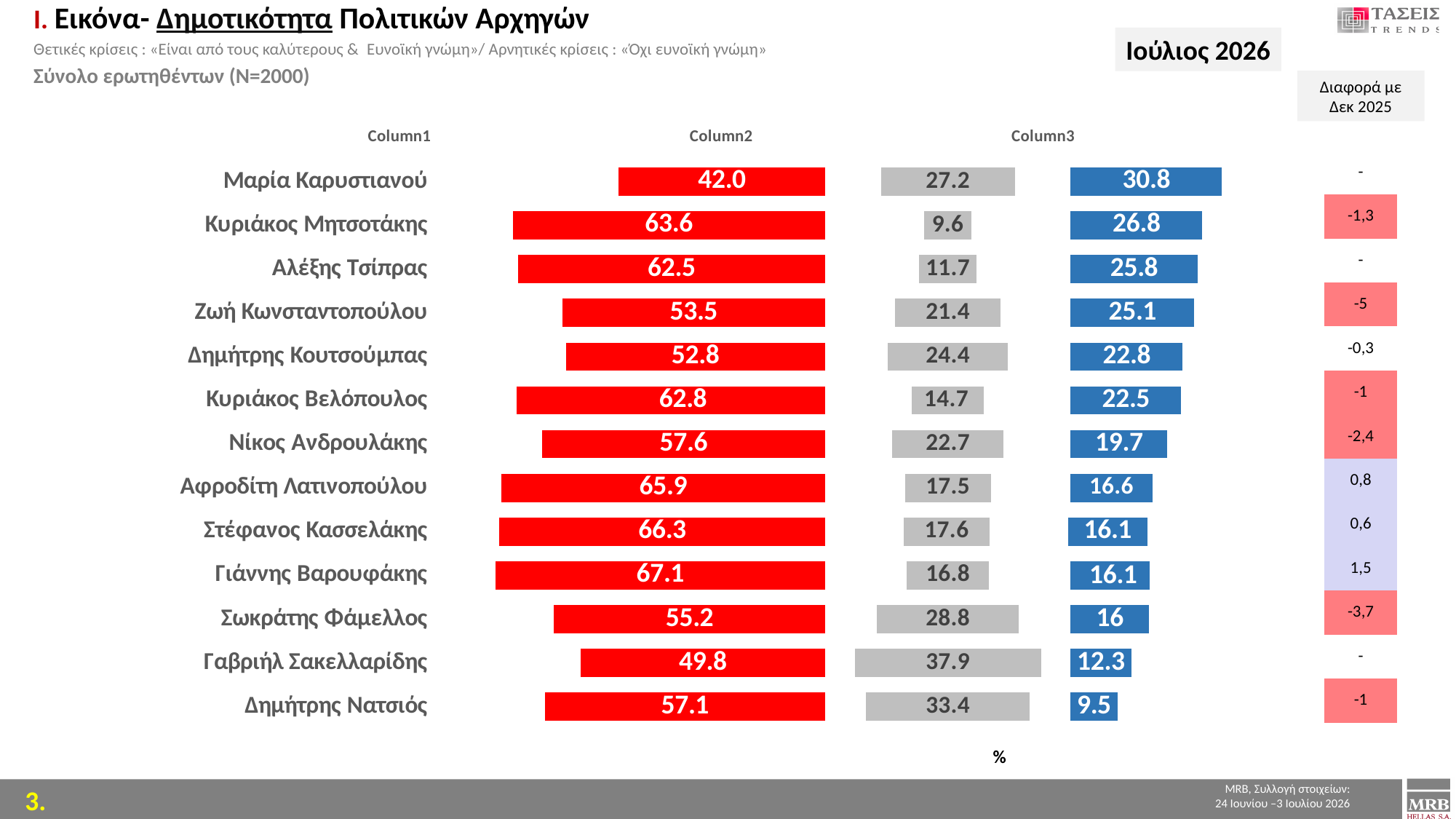
Which person has the highest value in the red bars (Column1)? Γιάννης Βαρουφάκης What is the value of the red bar (Column1) for Κυριάκος Μητσοτάκης? 63.6 What is the value of the grey bar (Column2) for Γαβριήλ Σακελλαρίδης? 37.9 How many series does the chart show? 3 What is the difference between the blue bar (Column3) values for Μαρία Καρυστιανού and Δημήτρης Νατσιός? 21.3 What kind of chart is shown on the slide? Bar chart How many people are listed in the chart? 13 Which person has the lowest value in the blue bars (Column3)? Δημήτρης Νατσιός What is the value of the blue bar (Column3) for Μαρία Καρυστιανού? 30.8 What colour are the Column3 bars? Blue Which person has the lowest value in the grey bars (Column2)? Κυριάκος Μητσοτάκης Which is larger, the red bar (Column1) value for Κυριάκος Βελόπουλος or for Νίκος Ανδρουλάκης? Κυριάκος Βελόπουλος